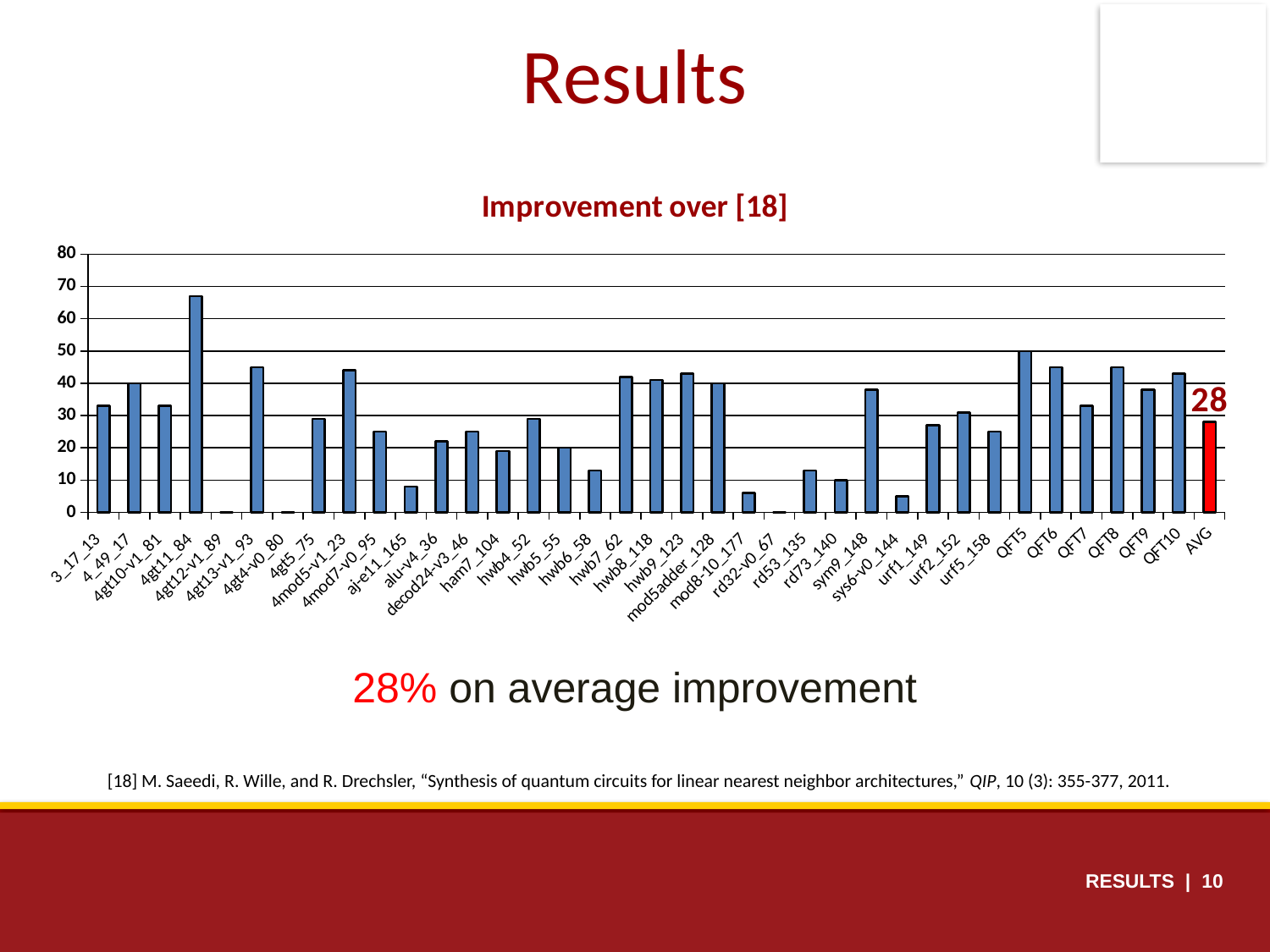
Is the value for hwb6_58 greater or less than 20? less Which has the larger value, hwb7_62 or rd73_140? hwb7_62 Which has the larger value, 4gt11_84 or QFT5? 4gt11_84 What kind of chart is shown on the slide? bar chart Is the value for QFT5 greater or less than 40? greater What is the title of the chart? Improvement over [18] How many categories are shown on the x axis of the chart? 37 Is the value for 4gt11_84 greater or less than 60? greater Which has the larger value, sym9_148 or sys6-v0_144? sym9_148 Which category has the highest bar in the chart? 4gt11_84 What is the value shown for the AVG bar? 28